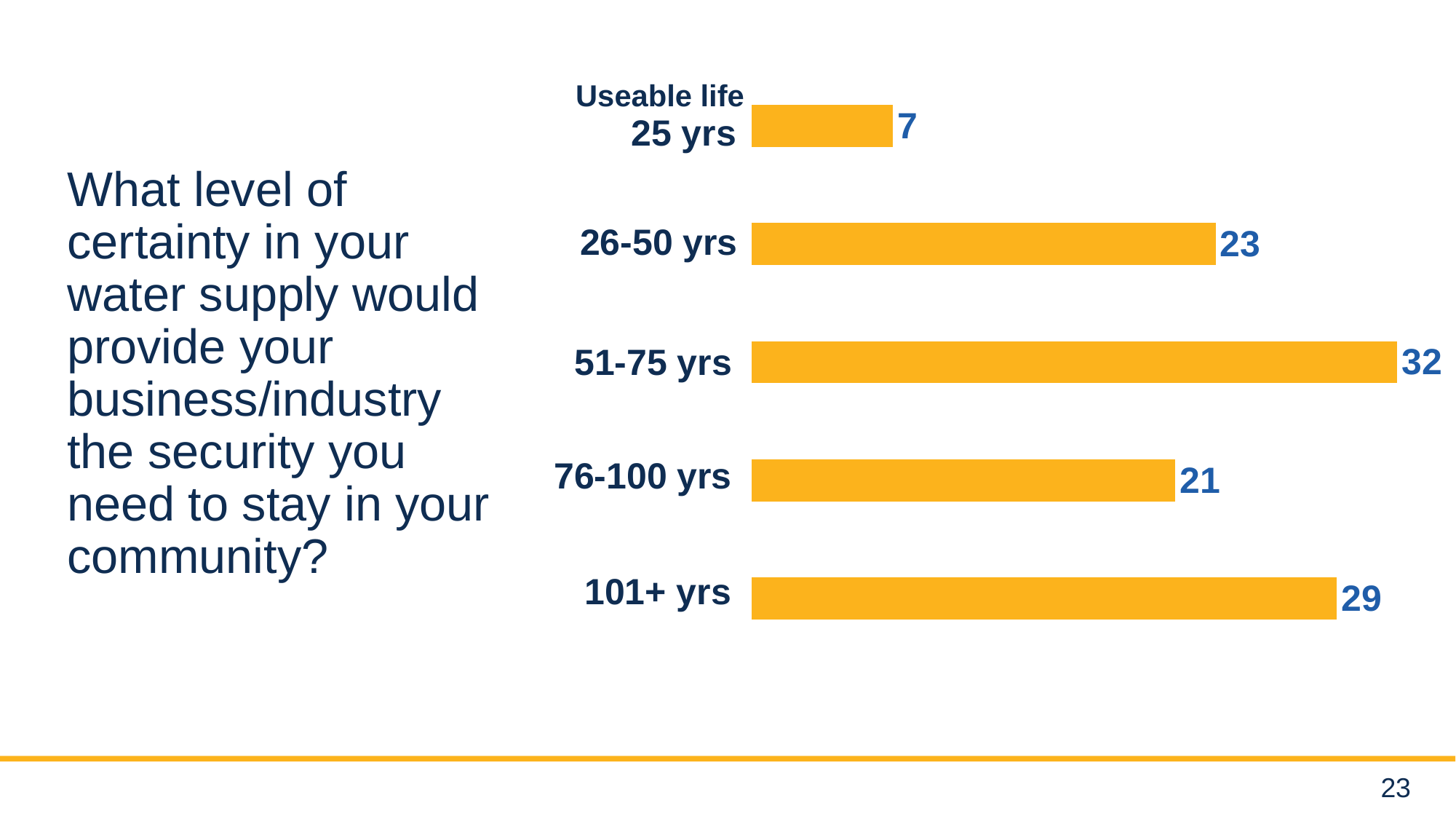
What is the difference between the values for 101+ yrs and 25 yrs? 22 What is the value for the 25 yrs category? 7 Which useable life category has the lowest value? 25 yrs What is the value for the 101+ yrs category? 29 What is the difference between the values for 51-75 yrs and 26-50 yrs? 9 Which is larger, the value for 26-50 yrs or the value for 76-100 yrs? 26-50 yrs What is the value for the 76-100 yrs category? 21 What colour are the bars in the chart? Yellow What kind of chart is shown on the slide? Bar chart Which useable life category has the highest value? 51-75 yrs How many useable life categories are shown in the chart? 5 What is the value for the 51-75 yrs category? 32